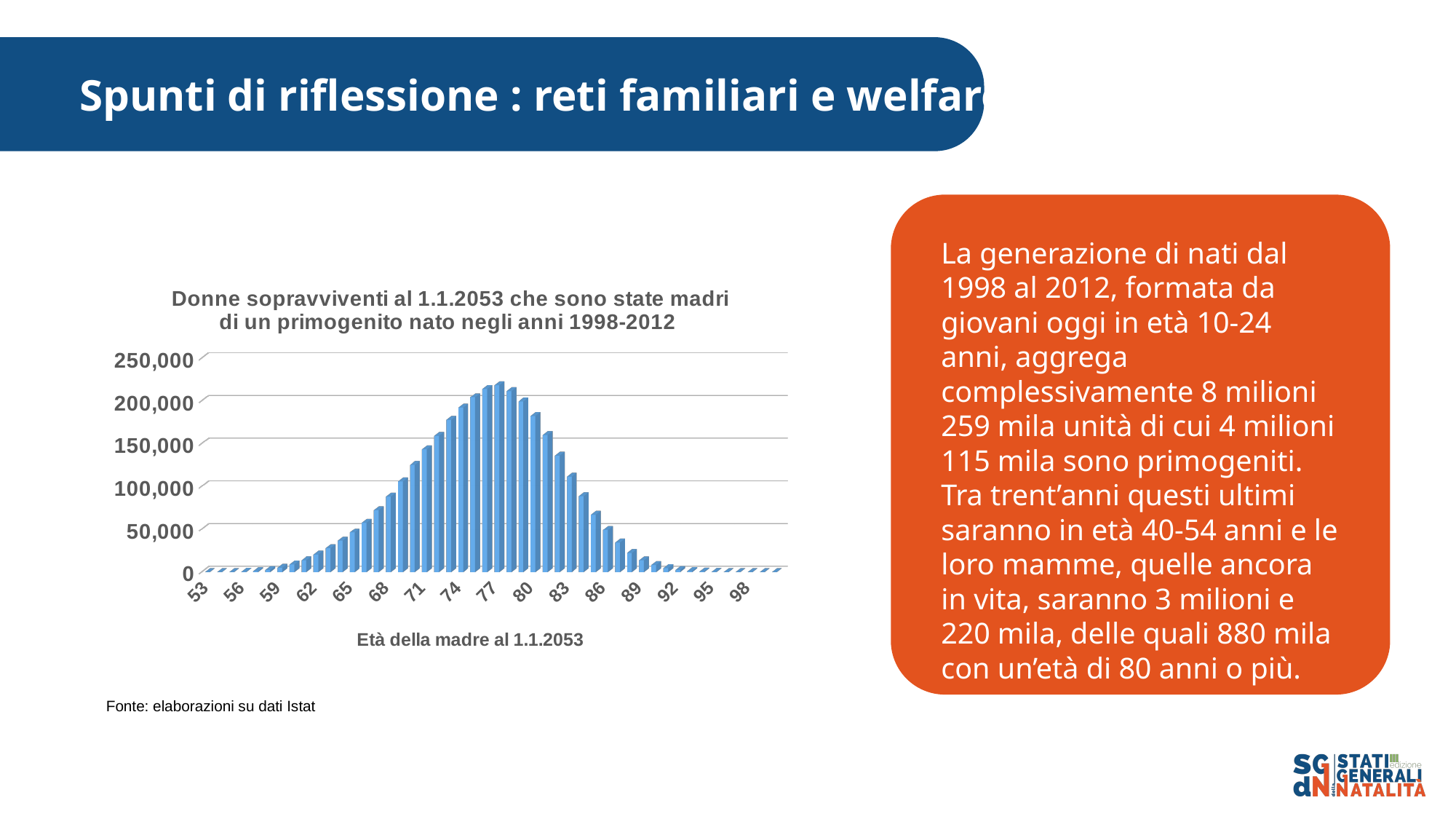
Is the value for mothers aged 77 greater or less than 200,000? greater Do the values rise or fall as the mother's age increases from 53 to 77? rise What kind of chart is shown on the slide? bar chart What is the source cited below the chart? Fonte: elaborazioni su dati Istat Is the value for mothers aged 89 greater or less than 50,000? less Is the value for mothers aged 68 greater or less than 100,000? less What is the title of the x axis of the chart? Età della madre al 1.1.2053 Which is larger, the value for mothers aged 74 or the value for mothers aged 86? 74 Do the values rise or fall as the mother's age increases from 80 to 98? fall